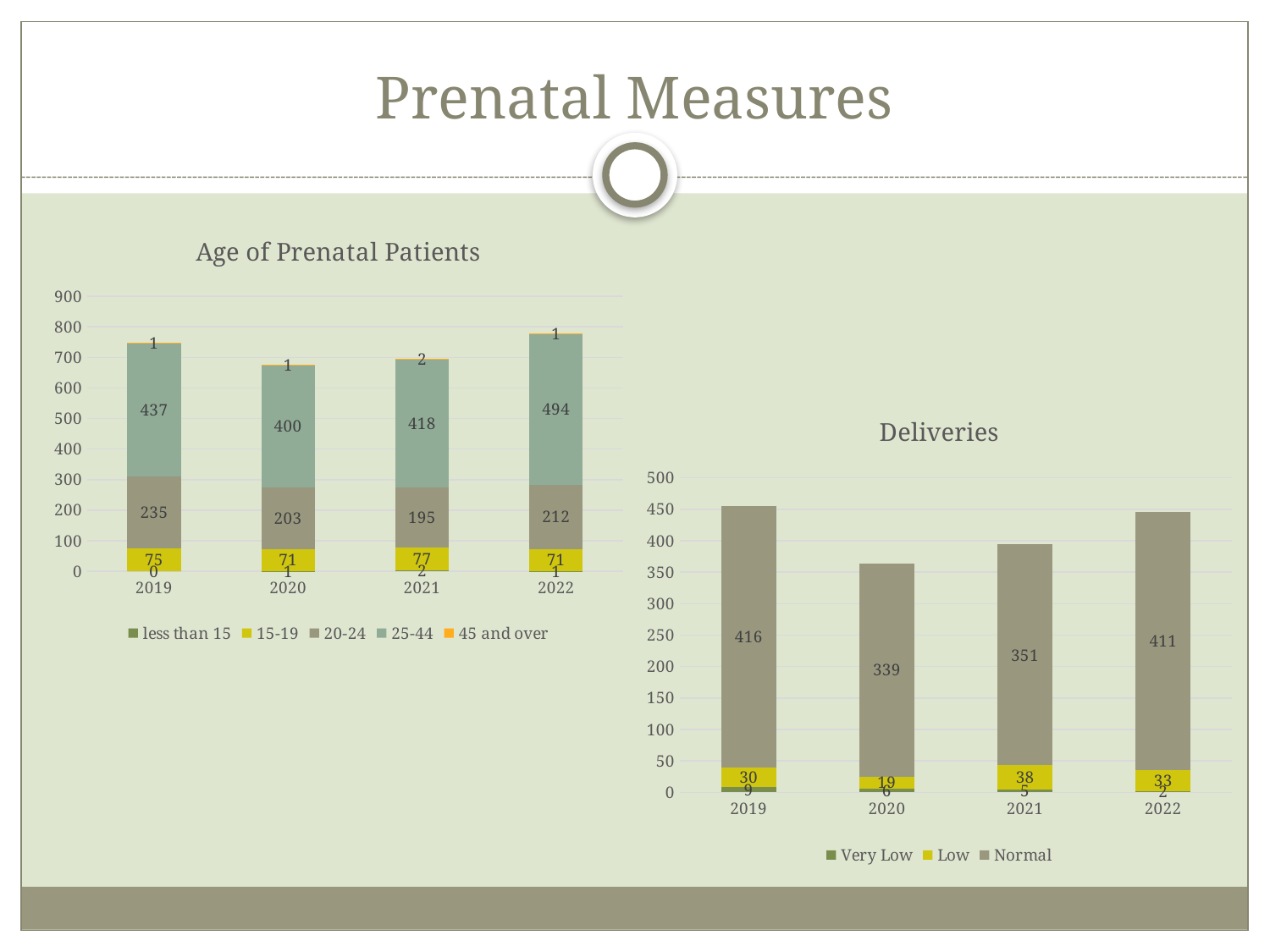
In the Age of Prenatal Patients chart, which year has the lowest value for the 20-24 series? 2021 In the Deliveries chart, what is the value for the Normal series in 2021? 351 In the Deliveries chart, what is the difference between the Normal values for 2019 and 2020? 77 In the Age of Prenatal Patients chart, how many series does the legend list? 5 In the Deliveries chart, what is the total of the stacked bar for 2022? 446 What kind of chart is the Deliveries chart? Stacked bar chart In the Age of Prenatal Patients chart, what is the total of the stacked bar for 2020? 676 In the Age of Prenatal Patients chart, which year has the highest value for the 25-44 series? 2022 In the Age of Prenatal Patients chart, what is the value for the 25-44 series in 2022? 494 In the Age of Prenatal Patients chart, what is the value for the 20-24 series in 2019? 235 In the Deliveries chart, which year has the highest value for the Low series? 2021 In the Deliveries chart, is the Very Low value for 2019 larger or smaller than the Very Low value for 2022? larger